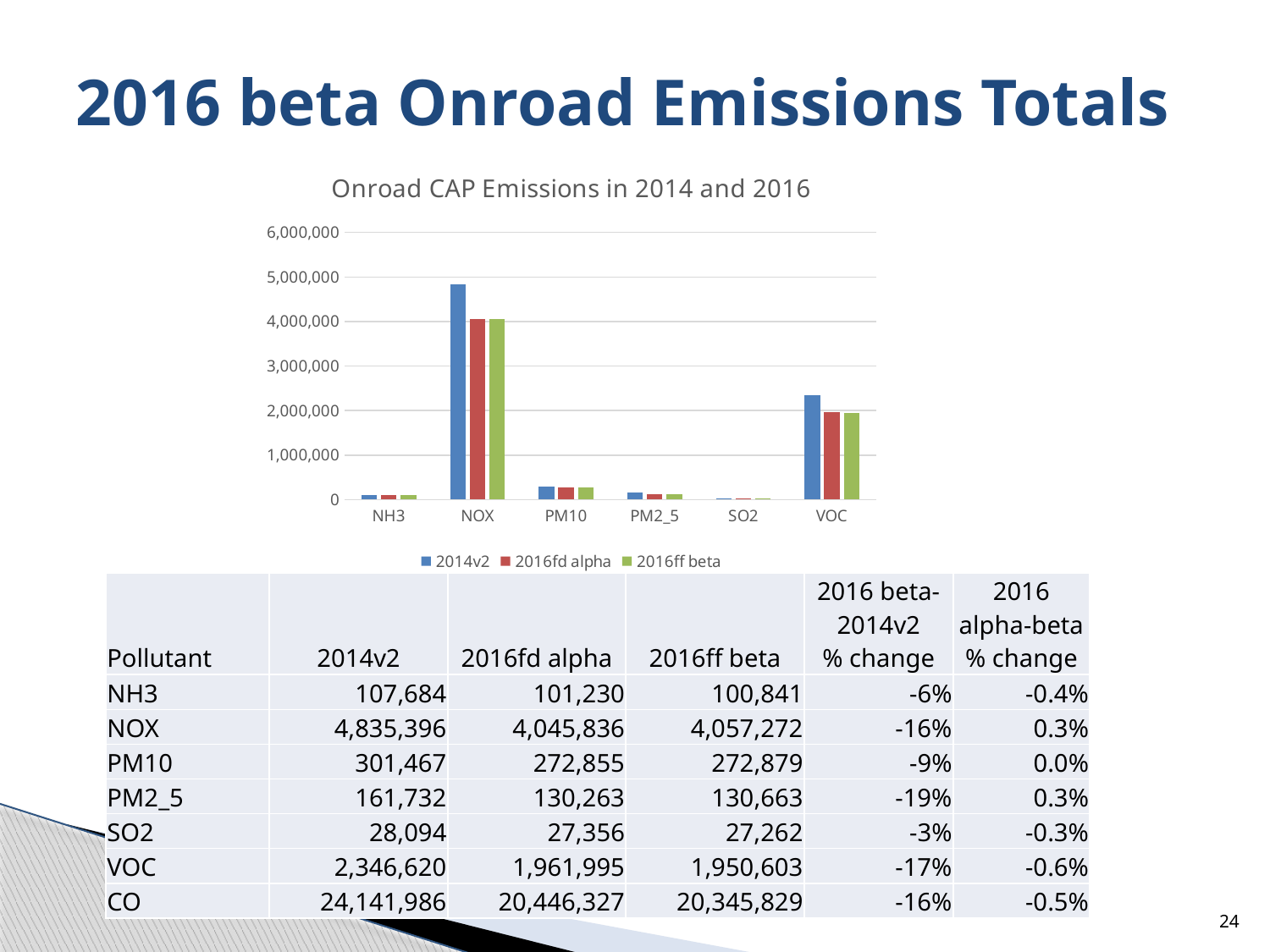
How many series does the chart legend list? 3 According to the table, what is the 2014v2 value for NOX? 4,835,396 According to the table, what is the 2016ff beta value for VOC? 1,950,603 Which is larger, the 2014v2 value for VOC or the 2014v2 value for PM10? VOC Is the 2014v2 value for VOC greater or less than 2,000,000? greater Which pollutant has the lowest emissions in the chart? SO2 What is the title of the chart? Onroad CAP Emissions in 2014 and 2016 Which pollutant has the highest emissions in the chart? NOX What type of chart is shown on the slide? bar chart How many pollutant categories are plotted on the chart's x axis? 6 Is the 2014v2 value for NOX greater or less than 4,000,000? greater Using the table values, what is the difference between the 2014v2 and 2016ff beta values for NOX? 778,124